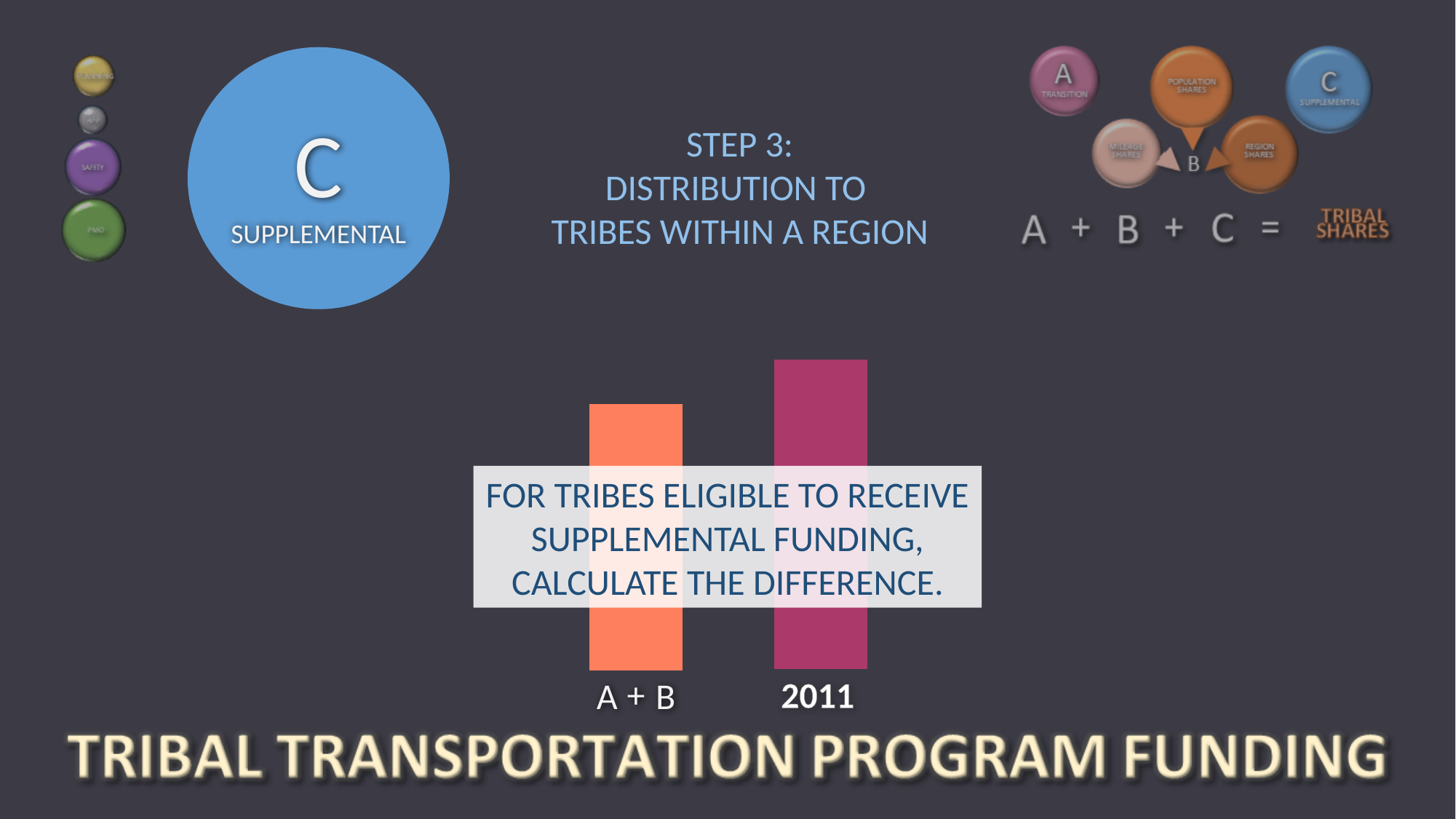
Which bar is taller, A + B or 2011? 2011 How many bars does the chart show? 2 What colour is the bar labelled 2011? magenta Which bar is the shortest in the chart? A + B What are the labels of the two bars in the chart? A + B and 2011 What kind of chart is shown on the slide? bar chart Which bar is the tallest in the chart? 2011